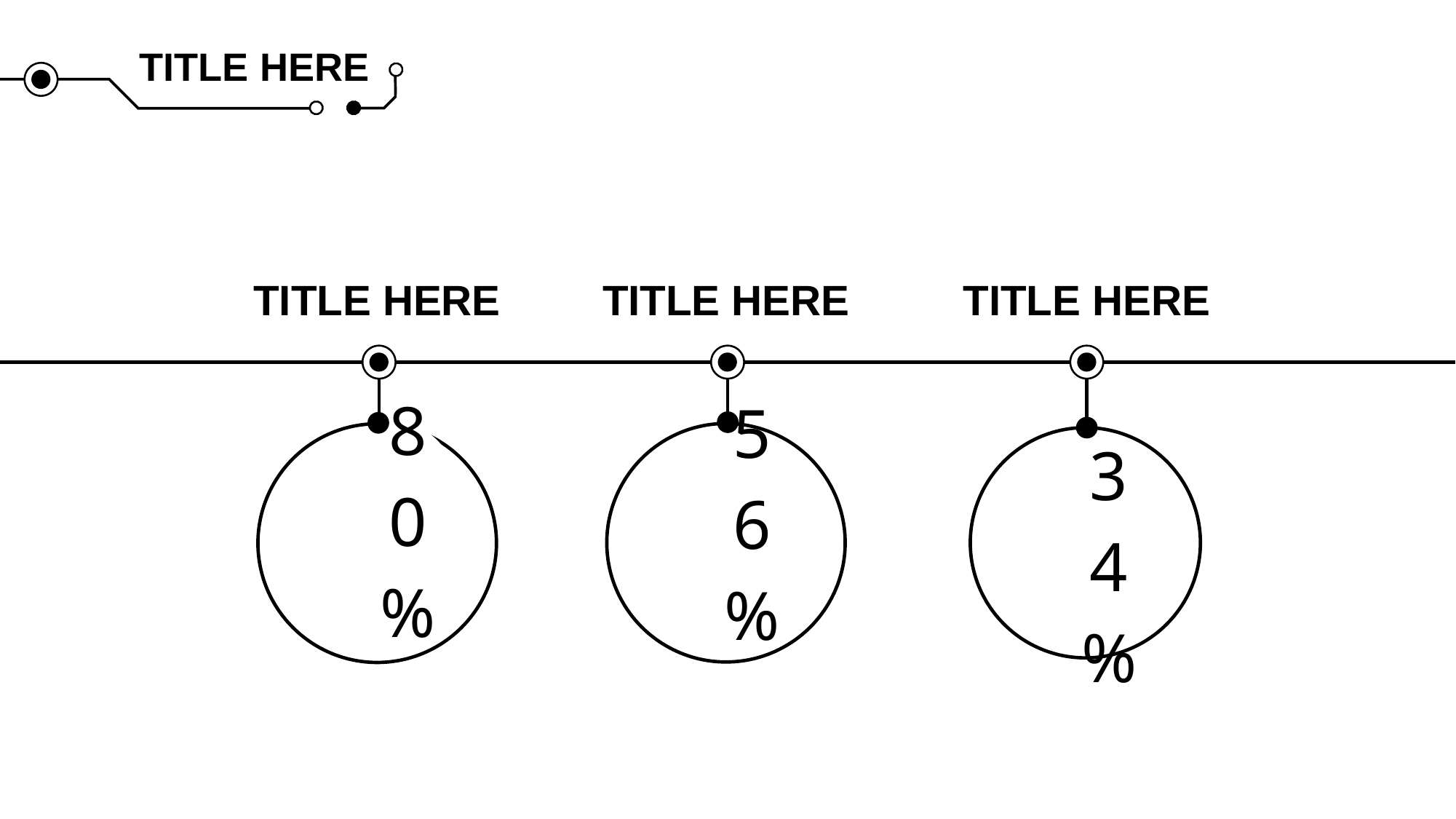
What value is shown in the right circle chart? 34% What value is shown in the left circle chart? 80% Is the value in the middle circle chart greater or less than 50%? greater Which of the three circle charts shows the lowest value: left, middle or right? right What value is shown in the middle circle chart? 56% How many circle charts are shown on the slide? 3 What is the difference between the value in the middle circle chart and the value in the right circle chart? 22% What is the difference between the value in the left circle chart and the value in the middle circle chart? 24% What is the difference between the value in the left circle chart and the value in the right circle chart? 46% What heading text appears above each of the three circle charts? TITLE HERE Which of the three circle charts shows the highest value: left, middle or right? left Which is larger, the value in the middle circle chart or the value in the right circle chart? middle